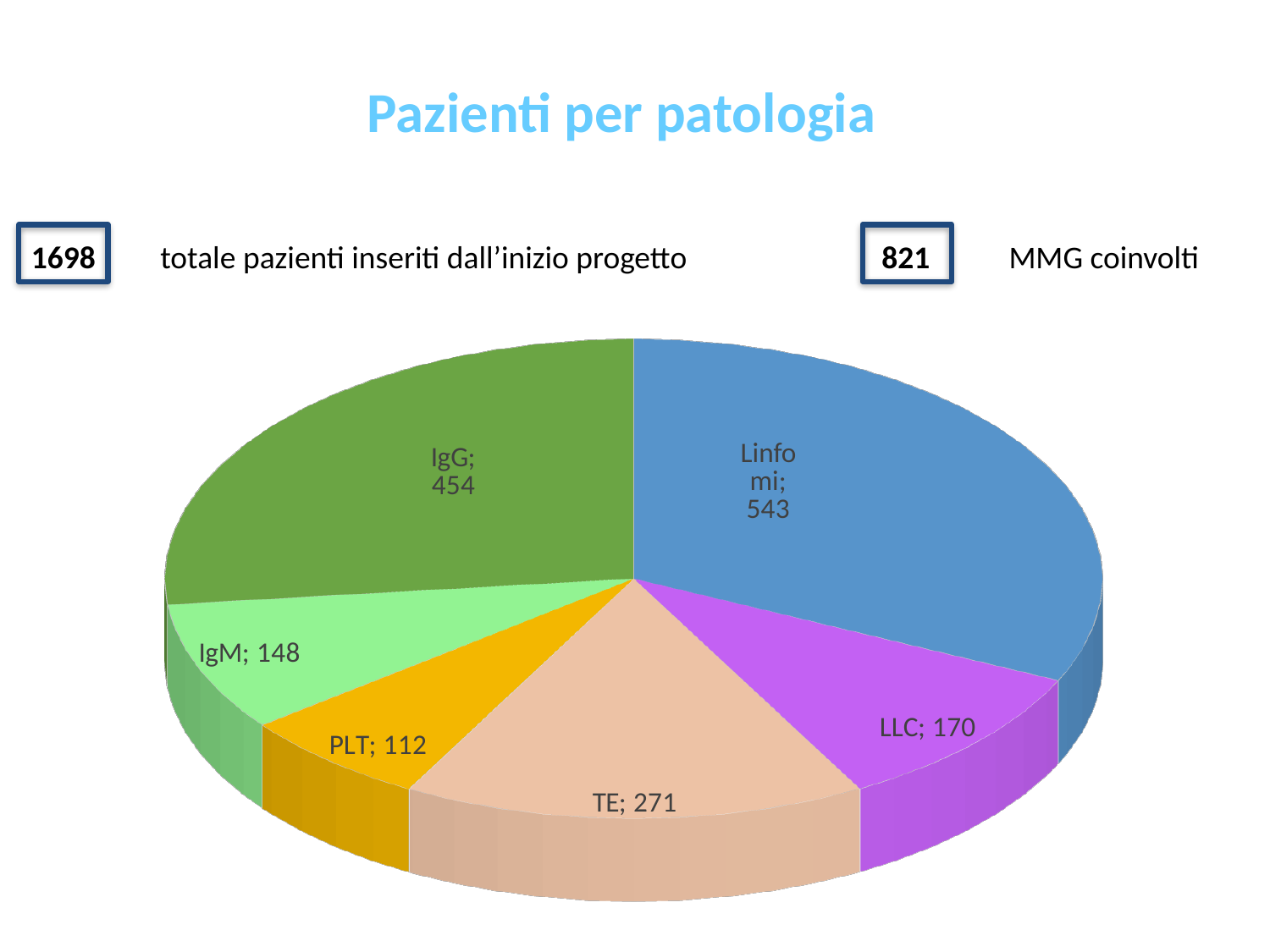
Which category has the smallest slice? PLT What is the value for TE? 271 What is the title of the chart? Pazienti per patologia What is the value for PLT? 112 What is the difference between the values for Linfomi and IgG? 89 Which category has the largest slice? Linfomi What is the total of all slices in the pie chart? 1698 Which is larger, the value for LLC or the value for IgM? LLC How many slices does the pie chart have? 6 What is the value for Linfomi? 543 What kind of chart is shown on the slide? pie chart What is the value for IgG? 454